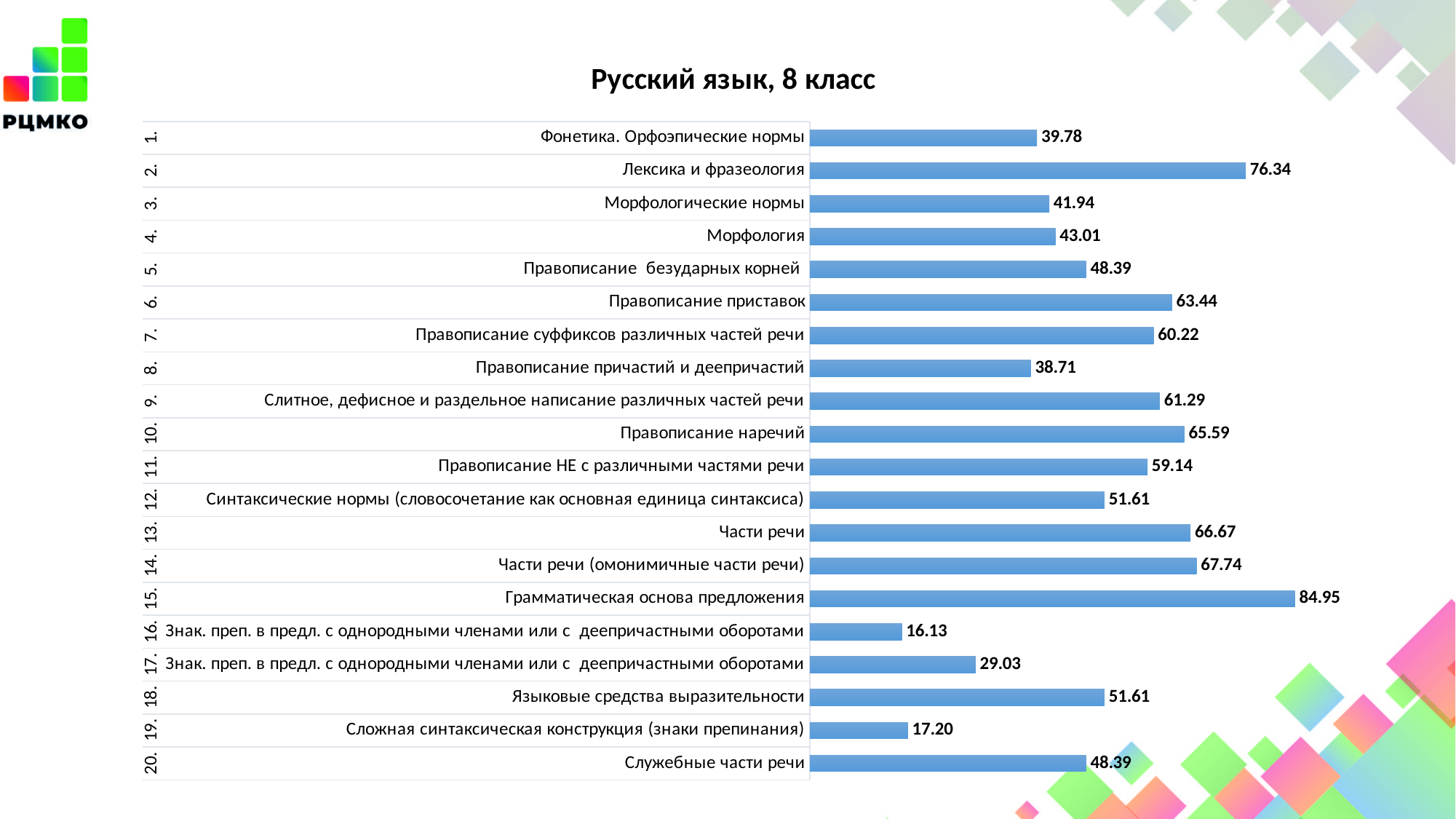
What is the title of the chart? Русский язык, 8 класс Which category has the lowest value? Знак. преп. в предл. с однородными членами или с деепричастными оборотами (16.13) What is the value for «Правописание наречий»? 65.59 What is the difference between the values for «Правописание приставок» and «Правописание суффиксов различных частей речи»? 3.22 What is the value for «Лексика и фразеология»? 76.34 What kind of chart is shown on the slide? Bar chart How many categories are shown in the chart? 20 What is the value for «Части речи»? 66.67 What is the difference between the values for «Грамматическая основа предложения» and «Лексика и фразеология»? 8.61 Which category has the highest value? Грамматическая основа предложения Which is larger: the value for «Морфология» or the value for «Морфологические нормы»? Морфология What is the value for «Сложная синтаксическая конструкция (знаки препинания)»? 17.20